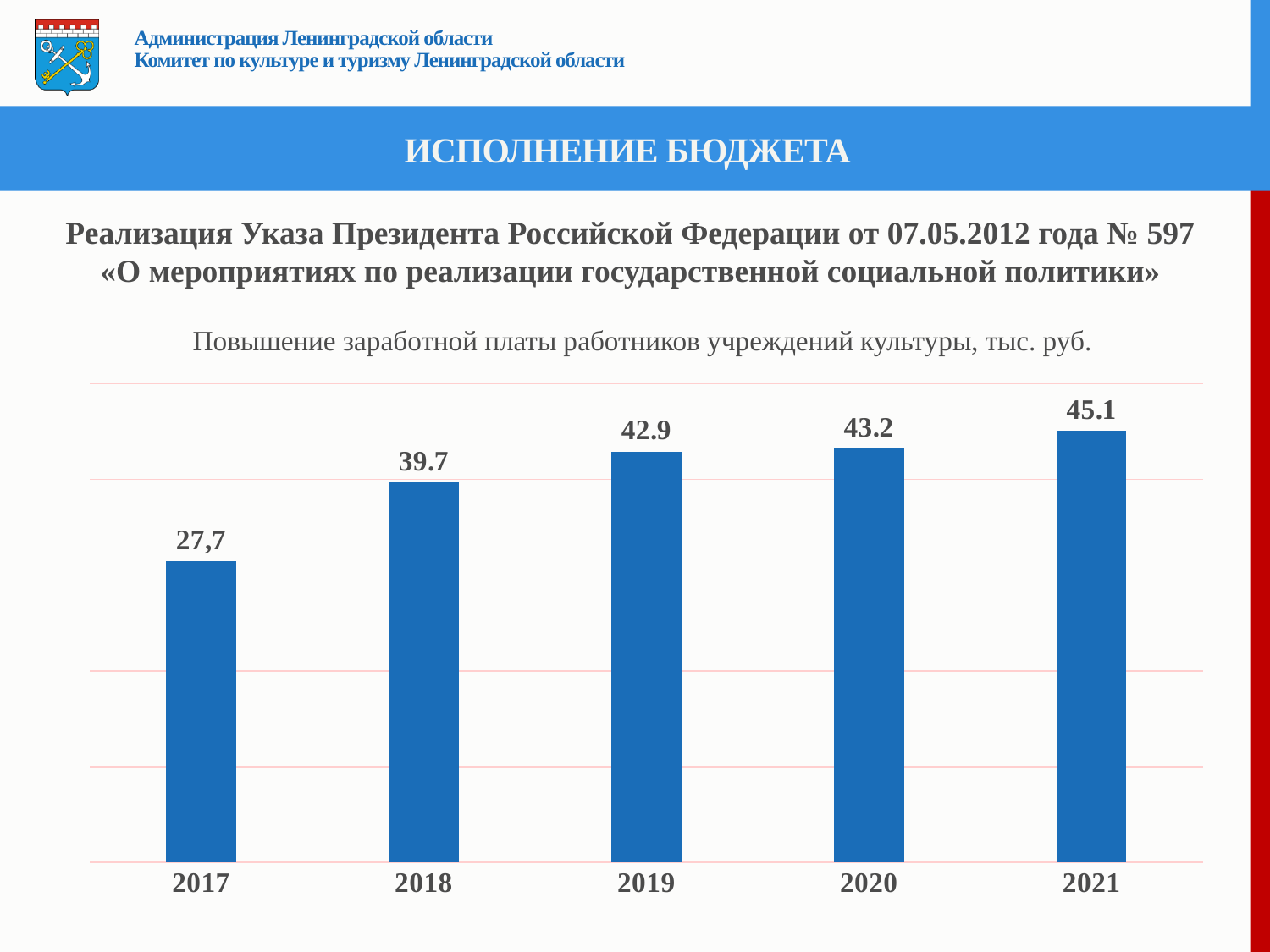
What is the difference between the values for 2019 and 2018? 3.2 How many years are shown on the x axis? 5 Which is larger, the value for 2018 or the value for 2019? 2019 Do the values rise or fall from 2017 to 2021? rise Which year has the highest value? 2021 Which year has the lowest value? 2017 What is the value for 2019? 42.9 What is the title of the chart? Повышение заработной платы работников учреждений культуры, тыс. руб. What is the difference between the values for 2021 and 2017? 17.4 What type of chart is shown on the slide? bar chart What is the value for 2017? 27,7 What is the value for 2021? 45.1